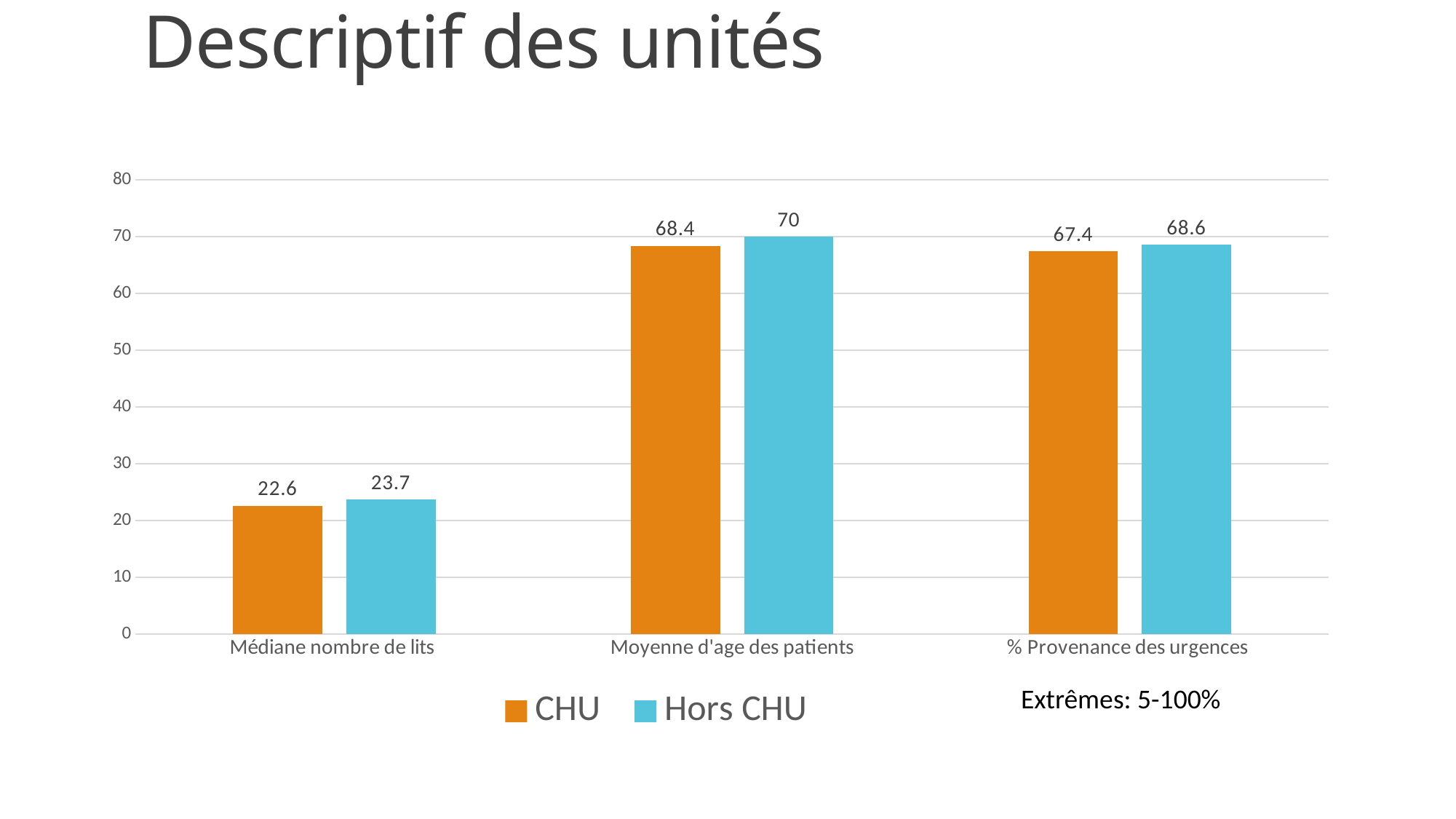
How many series does the legend list? 2 What is the Hors CHU value for Moyenne d'age des patients? 70 What is the difference between the Hors CHU and CHU values for Moyenne d'age des patients? 1.6 Which category has the lowest CHU value? Médiane nombre de lits What is the difference between the Hors CHU and CHU values for % Provenance des urgences? 1.2 What is the CHU value for Médiane nombre de lits? 22.6 Which category has the highest Hors CHU value? Moyenne d'age des patients What is the CHU value for % Provenance des urgences? 67.4 How many categories are shown on the x axis? 3 What kind of chart is shown on the slide? Bar chart What is the Hors CHU value for Médiane nombre de lits? 23.7 For Médiane nombre de lits, which series has the larger value, CHU or Hors CHU? Hors CHU